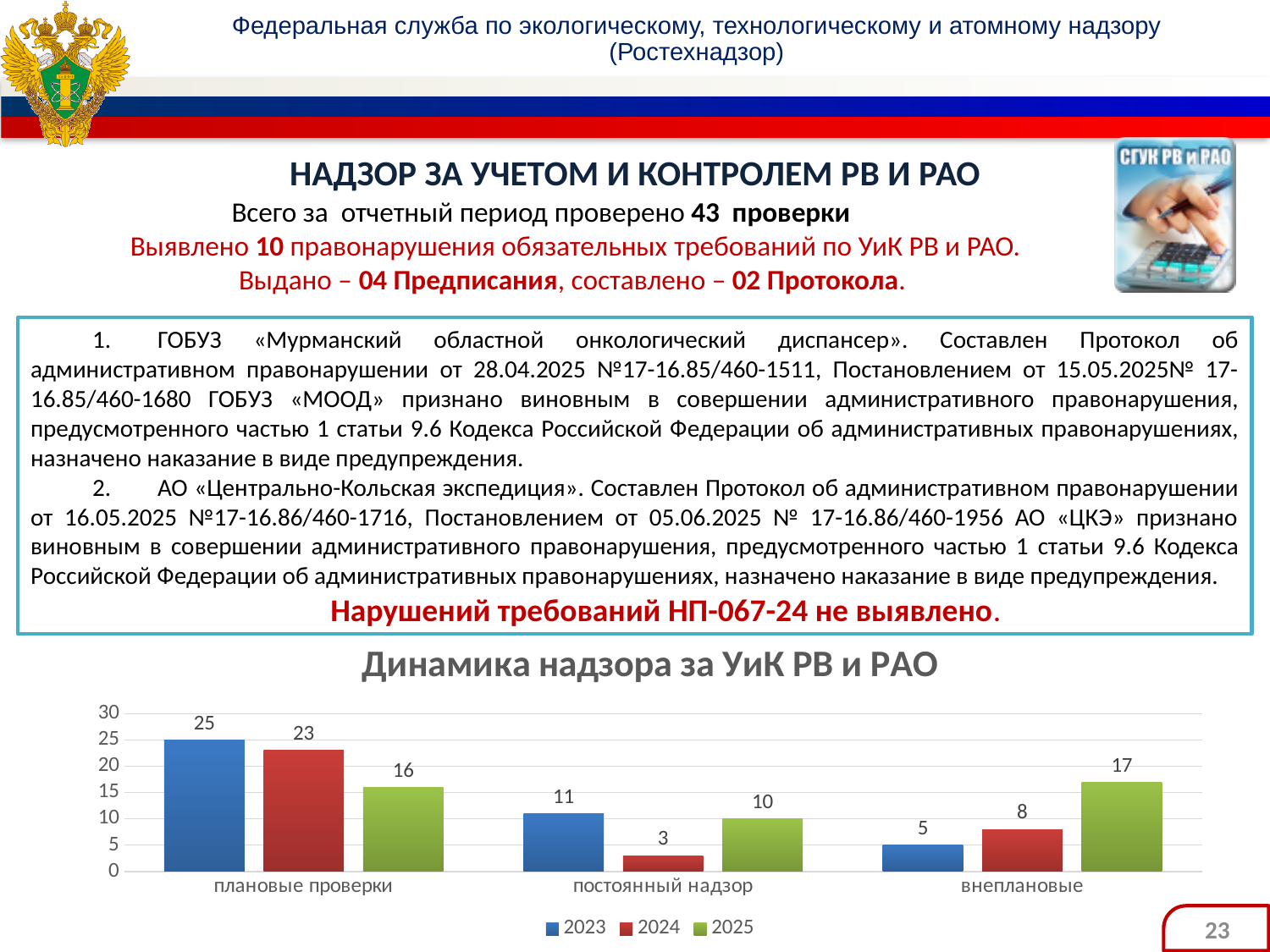
What is the value for 2025 in the 'внеплановые' category? 17 What is the difference between the 2023 and 2025 values in the 'плановые проверки' category? 9 What is the value for 2023 in the 'плановые проверки' category? 25 What is the title of the chart? Динамика надзора за УиК РВ и РАО How many series does the chart legend list? 3 What is the value for 2024 in the 'постоянный надзор' category? 3 Is the 2025 value for 'постоянный надзор' greater or less than 15? less What kind of chart is shown on the slide? bar chart How many categories are shown on the x axis of the chart? 3 Which year has the highest value in the 'плановые проверки' category? 2023 Which is larger: the 2024 value for 'внеплановые' or the 2024 value for 'постоянный надзор'? внеплановые Which year has the lowest value in the 'внеплановые' category? 2023